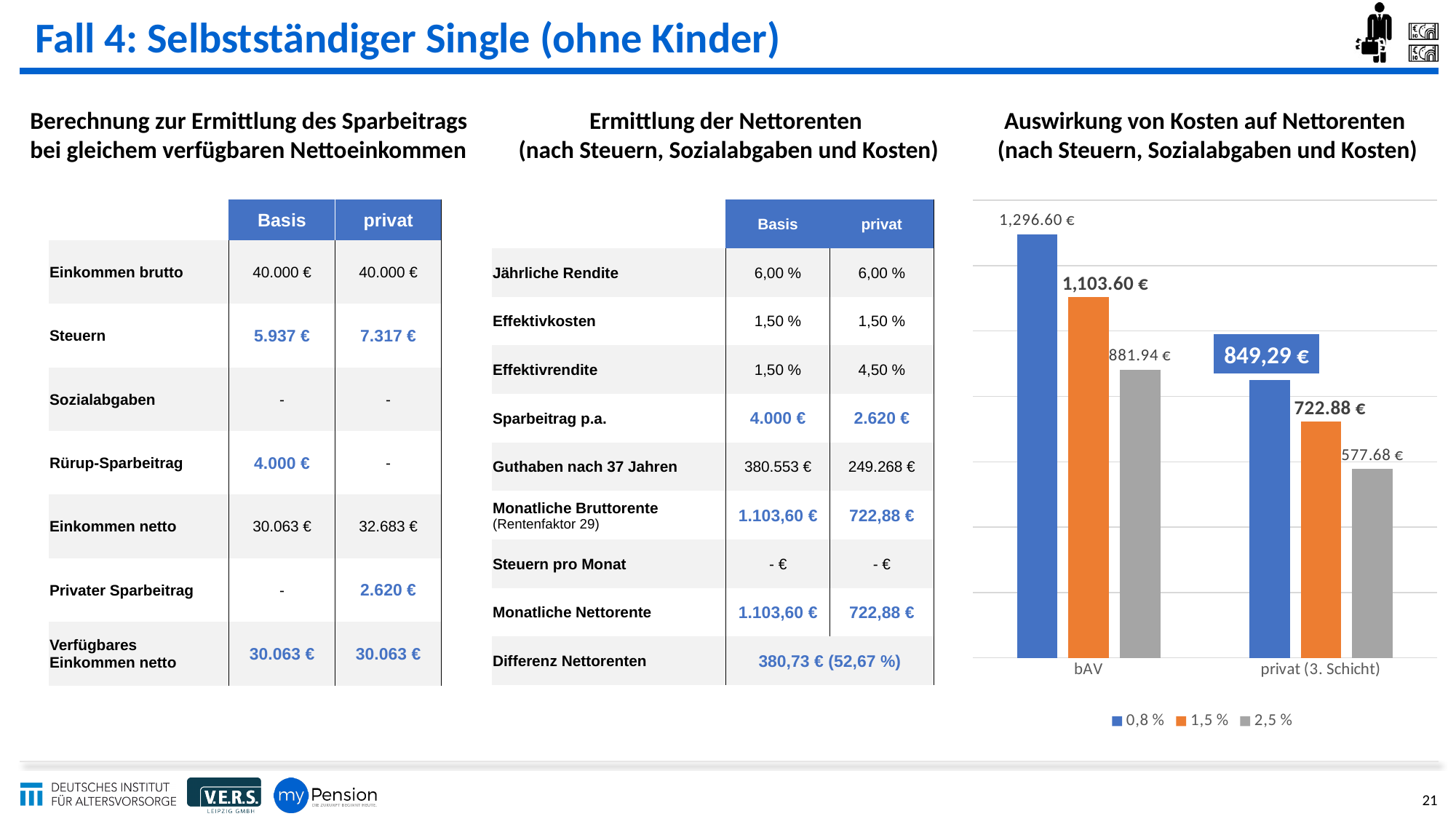
In the chart 'Auswirkung von Kosten auf Nettorenten', which is larger: the 1,5 % value for bAV or the 0,8 % value for privat (3. Schicht)? bAV, 1,5 % In the chart 'Auswirkung von Kosten auf Nettorenten', which bar has the lowest value? privat (3. Schicht), 2,5 % In the chart 'Auswirkung von Kosten auf Nettorenten', what is the difference between the 0,8 % and 1,5 % values for bAV? 193.00 € In the chart 'Auswirkung von Kosten auf Nettorenten', what is the value for privat (3. Schicht) in the 1,5 % series? 722.88 € In the chart 'Auswirkung von Kosten auf Nettorenten', what is the value for bAV in the 0,8 % series? 1,296.60 € What type of chart is shown under the title 'Auswirkung von Kosten auf Nettorenten'? bar chart In the chart 'Auswirkung von Kosten auf Nettorenten', what is the value for privat (3. Schicht) in the 0,8 % series? 849,29 € In the chart 'Auswirkung von Kosten auf Nettorenten', which bar has the highest value? bAV, 0,8 % In the chart 'Auswirkung von Kosten auf Nettorenten', which colour represents the 2,5 % series? grey In the chart 'Auswirkung von Kosten auf Nettorenten', how many categories are shown on the x axis? 2 In the chart 'Auswirkung von Kosten auf Nettorenten', what is the value for bAV in the 2,5 % series? 881.94 € In the chart 'Auswirkung von Kosten auf Nettorenten', how many series does the legend list? 3